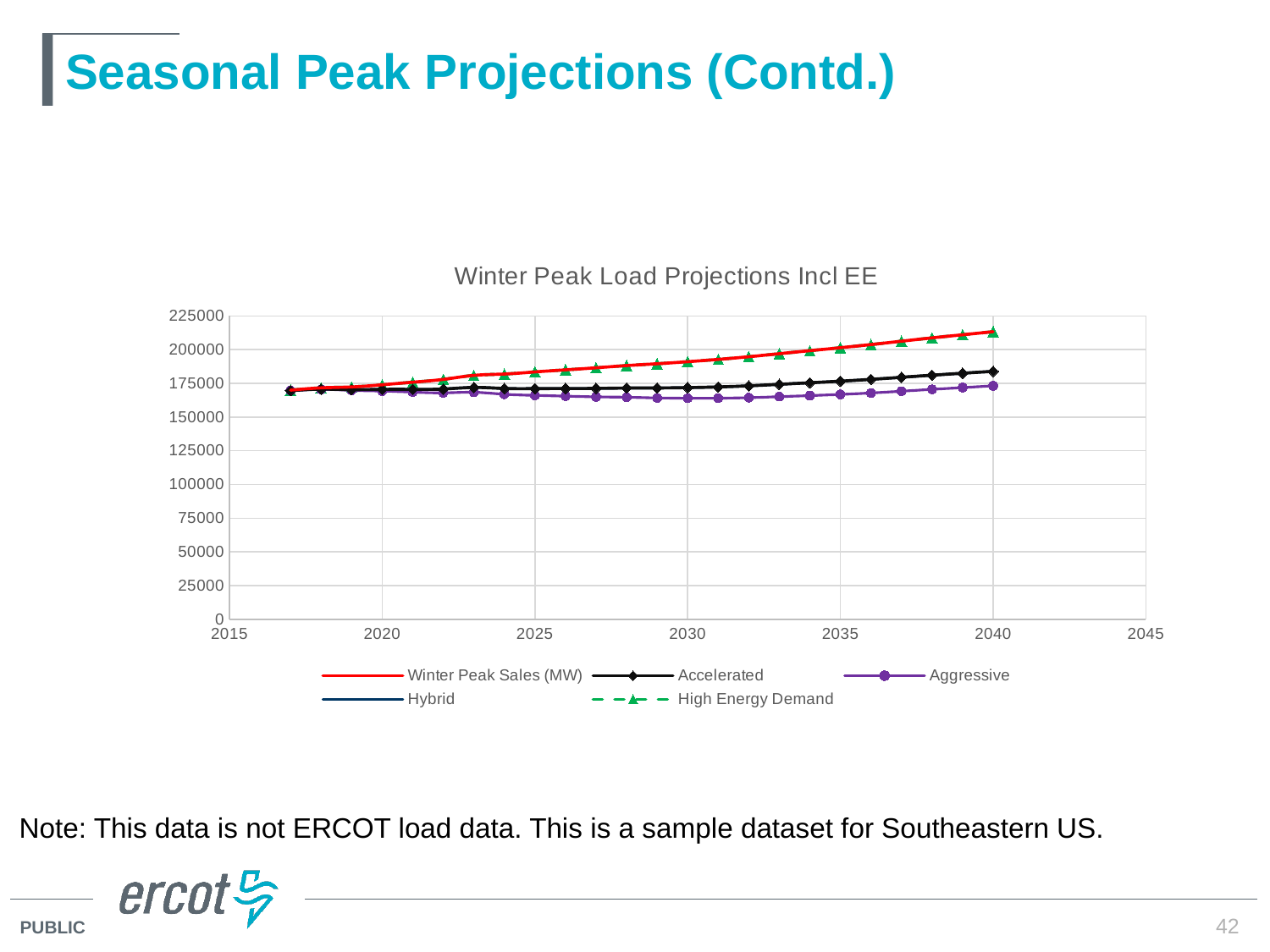
Is the value for Winter Peak Sales (MW) in 2030 greater or less than 175000? greater Is the value for Accelerated in 2030 greater or less than 150000? greater Is the value for Aggressive in 2030 greater or less than 175000? less What is the title of the chart? Winter Peak Load Projections Incl EE Does the Winter Peak Sales (MW) series rise or fall from 2017 to 2040? rise What kind of chart is shown on the slide? line chart What colour is the Winter Peak Sales (MW) line in the legend? red How many series does the chart's legend list? 5 In 2040, which is larger, Winter Peak Sales (MW) or Aggressive? Winter Peak Sales (MW) In 2035, which is lower, Accelerated or Aggressive? Aggressive